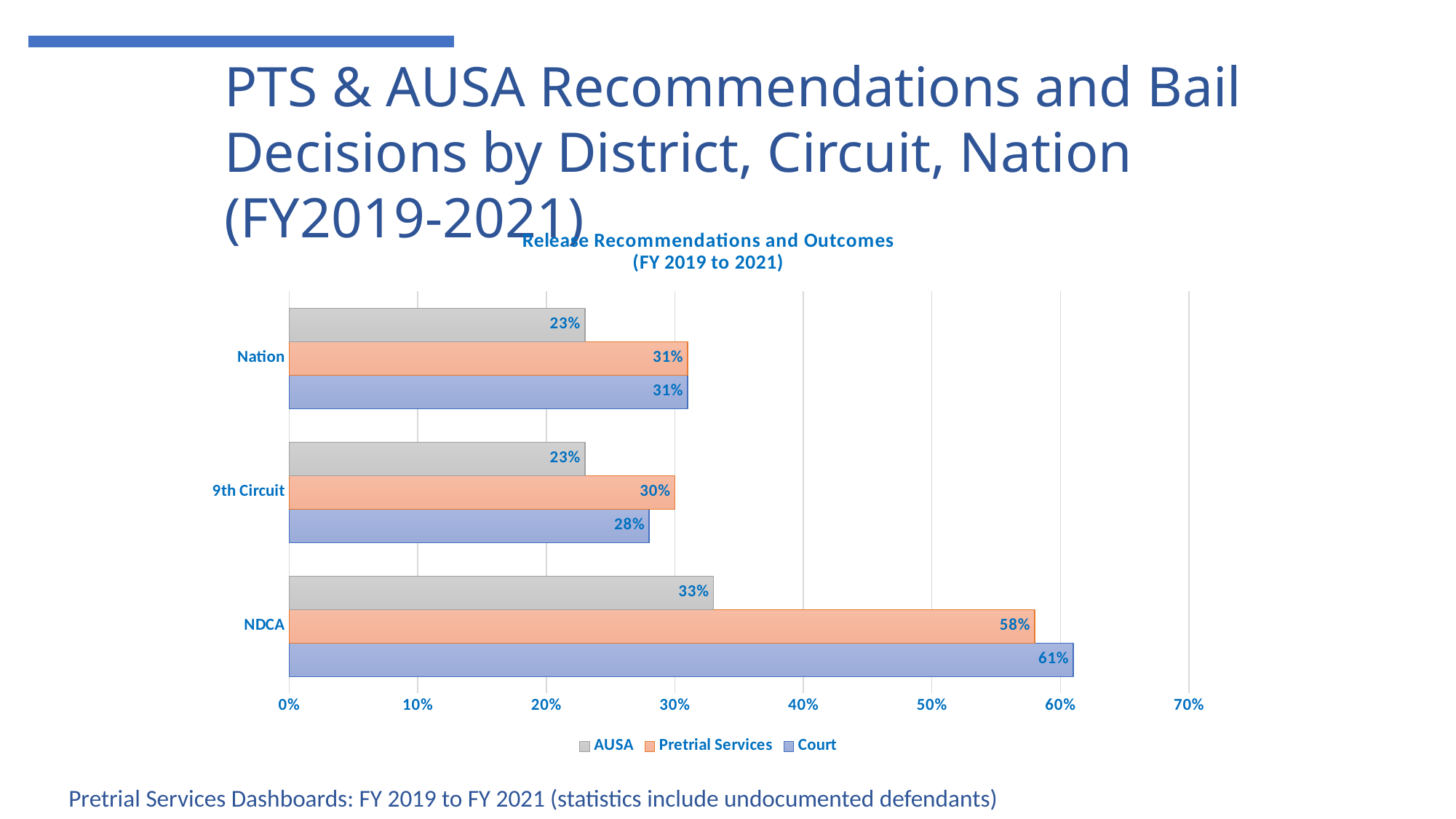
What is the Court value for NDCA? 61% How many series does the legend list? 3 Which category has the lowest Court value? 9th Circuit What is the Pretrial Services value for Nation? 31% Which is larger for the 9th Circuit, the Pretrial Services value or the Court value? Pretrial Services What is the AUSA value for the 9th Circuit? 23% What is the title of the chart? Release Recommendations and Outcomes (FY 2019 to 2021) What is the difference between the Court and AUSA values for NDCA? 28% Is the Pretrial Services value for NDCA greater or less than 50%? greater Which category has the highest Pretrial Services value? NDCA How many categories are shown on the y axis? 3 What kind of chart is shown? bar chart